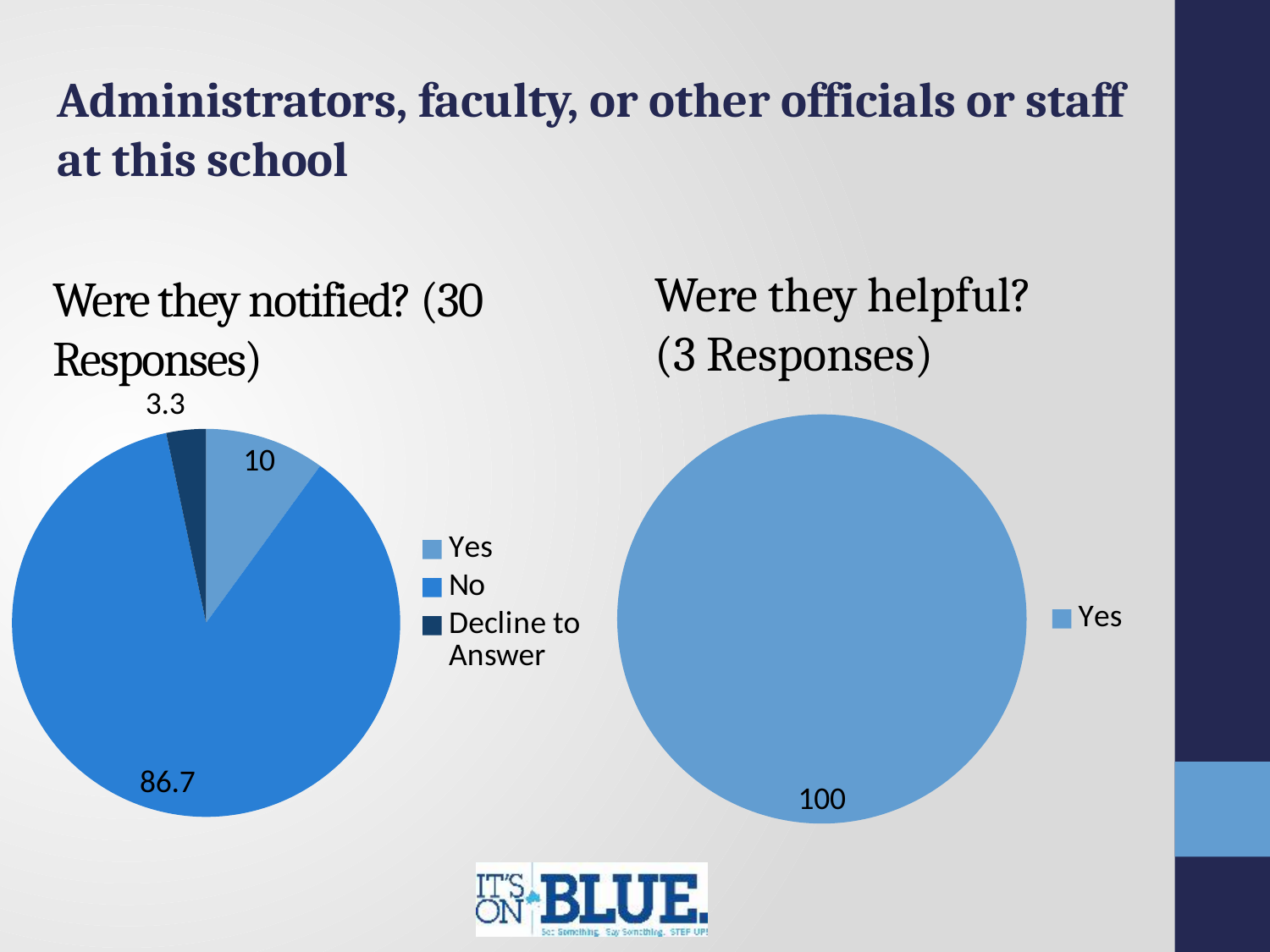
How many responses does the 'Were they notified?' chart title say it is based on? 30 Responses How many responses does the 'Were they helpful?' chart title say it is based on? 3 Responses In the 'Were they helpful?' chart, what is the value for Yes? 100 How many categories does the legend of the 'Were they notified?' chart list? 3 In the 'Were they notified?' chart, what is the value for Decline to Answer? 3.3 In the 'Were they notified?' chart, which is larger, Yes or Decline to Answer? Yes In the 'Were they notified?' chart, which category has the largest slice? No In the 'Were they notified?' chart, what is the difference between the values for No and Yes? 76.7 In the 'Were they notified?' chart, which category has the smallest slice? Decline to Answer What kind of chart is the 'Were they helpful?' chart? Pie chart In the 'Were they notified?' chart, what is the value for Yes? 10 In the 'Were they notified?' chart, what is the value for No? 86.7